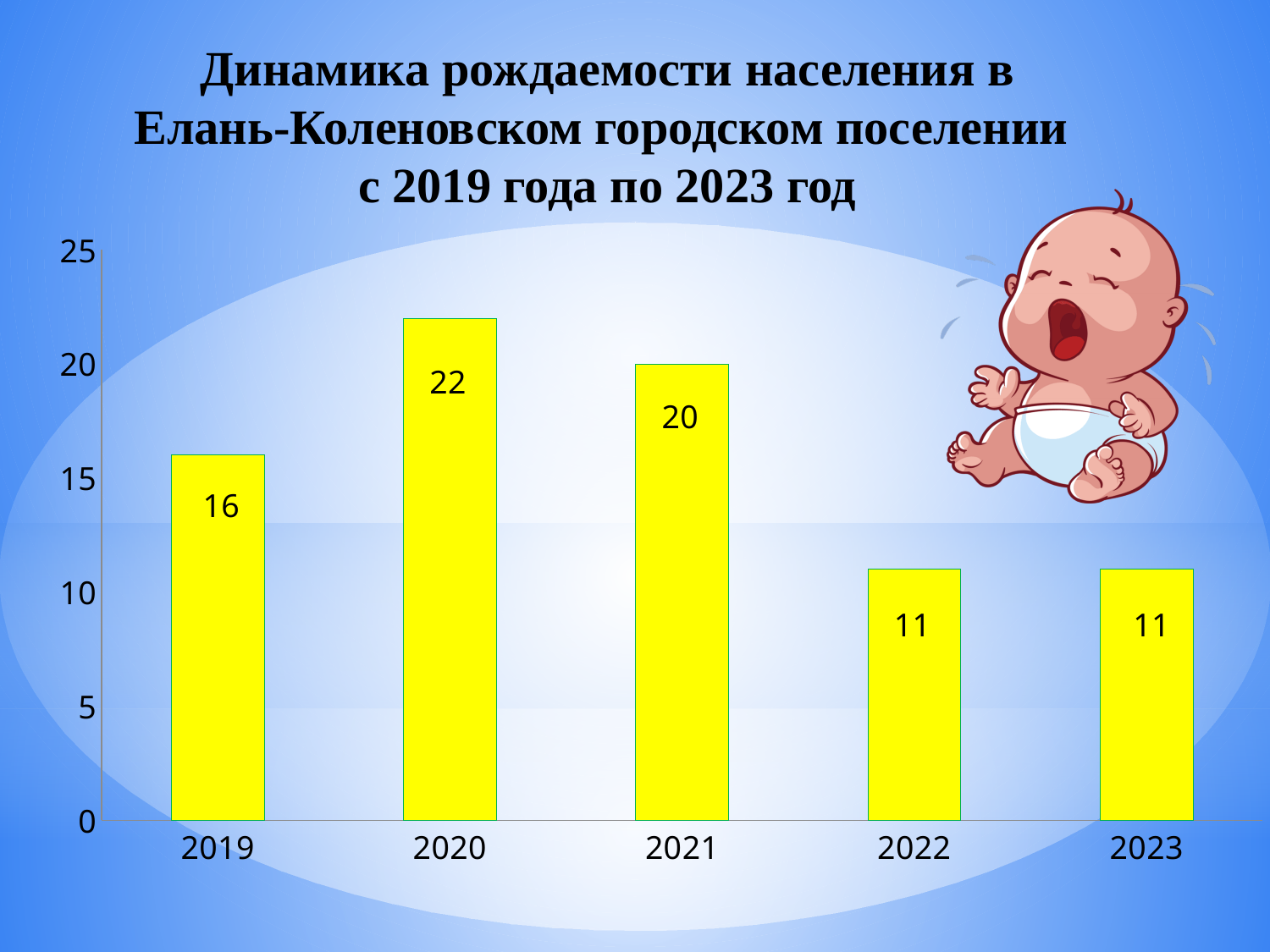
What is the value for 2022? 11 Which is larger, the value for 2019 or the value for 2021? 2021 Is the value for 2020 greater or less than 20? greater What is the difference between the values for 2019 and 2023? 5 What colour are the bars in the chart? yellow What is the value for 2020? 22 What kind of chart is shown on the slide? bar chart Which year has the highest value? 2020 Do the values rise or fall from 2021 to 2022? fall How many years are shown on the x axis? 5 What is the value for 2019? 16 What is the difference between the values for 2020 and 2021? 2